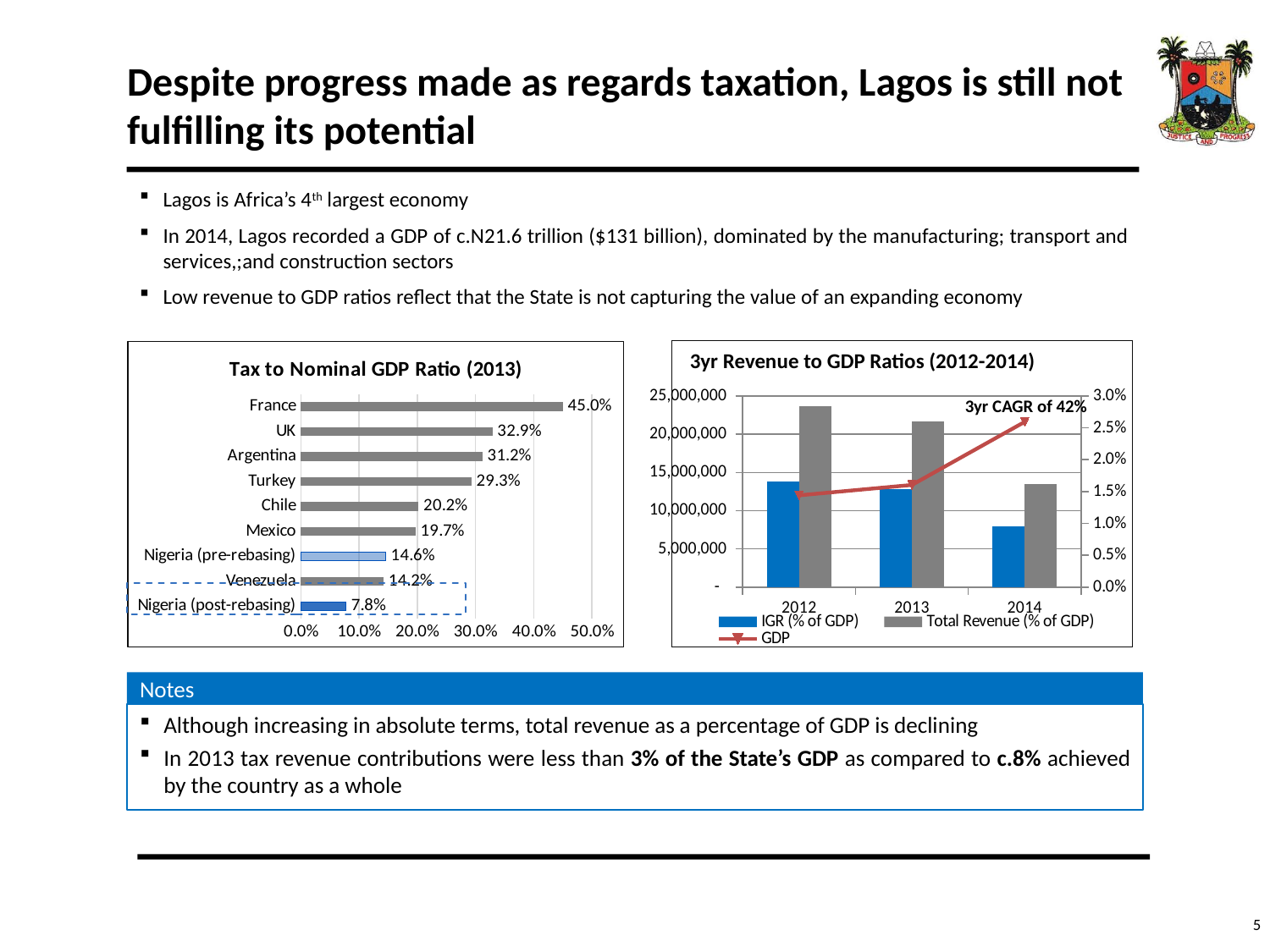
In the Tax to Nominal GDP Ratio (2013) chart, what is the value for Nigeria (post-rebasing)? 7.8% How many categories are shown in the Tax to Nominal GDP Ratio (2013) chart? 9 In the Tax to Nominal GDP Ratio (2013) chart, which is larger, Chile or Mexico? Chile In the Tax to Nominal GDP Ratio (2013) chart, what is the value for France? 45.0% In the 3yr Revenue to GDP Ratios (2012-2014) chart, does the GDP line rise or fall from 2012 to 2014? Rise In the Tax to Nominal GDP Ratio (2013) chart, what is the difference between the UK and Turkey? 3.6% What kind of chart is the Tax to Nominal GDP Ratio (2013) chart? Bar chart How many series does the legend of the 3yr Revenue to GDP Ratios (2012-2014) chart list? 3 In the Tax to Nominal GDP Ratio (2013) chart, which country has the highest ratio? France In the Tax to Nominal GDP Ratio (2013) chart, which category has the lowest ratio? Nigeria (post-rebasing)